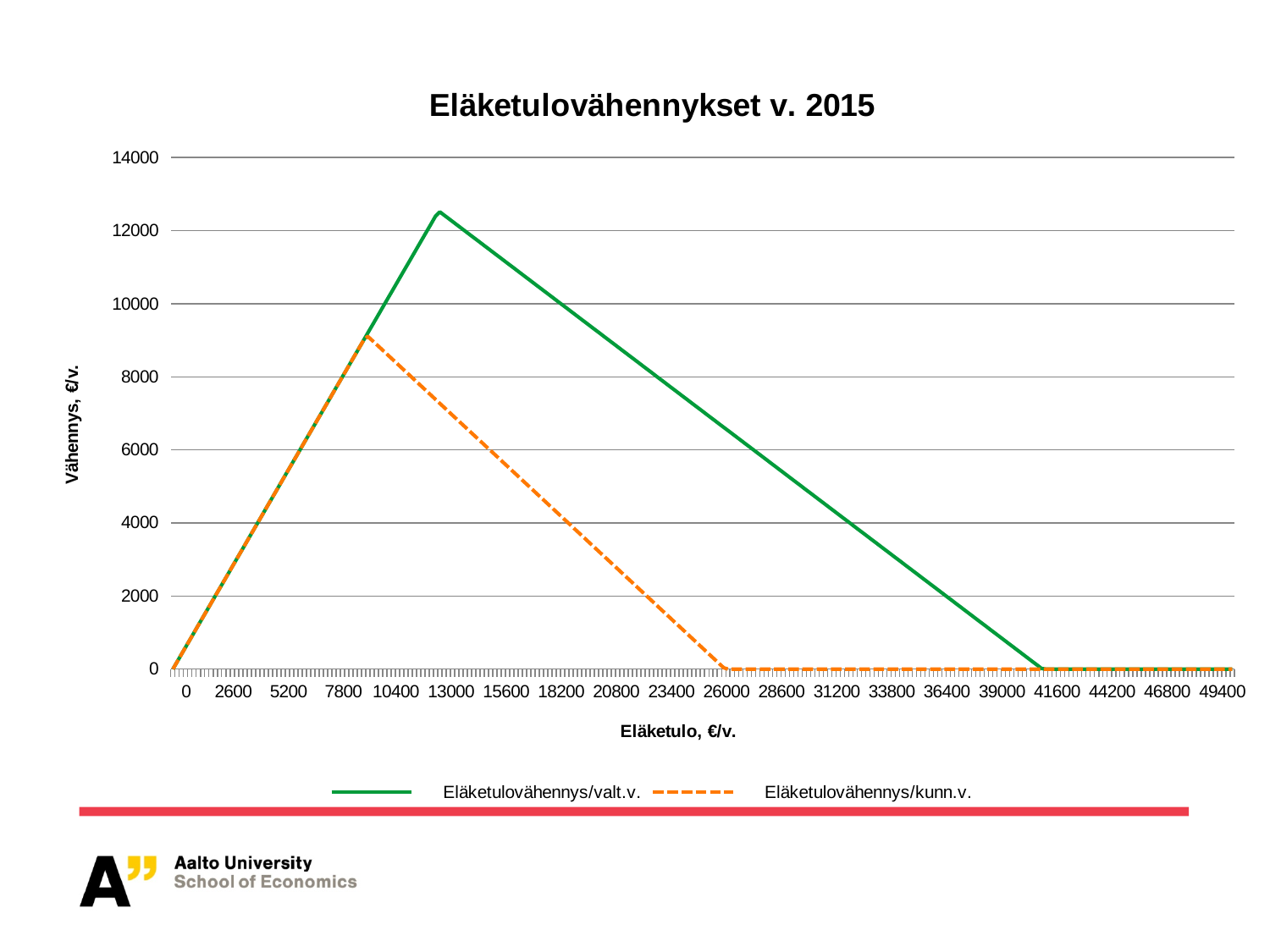
Is the value of Eläketulovähennys/valt.v. at Eläketulo 33800 greater or less than 4000? less Is the peak value of Eläketulovähennys/kunn.v. greater or less than 10000? less How many series does the legend list? 2 Is the value of Eläketulovähennys/kunn.v. at Eläketulo 13000 greater or less than 6000? greater What is the label of the y axis? Vähennys, €/v. At Eläketulo 20800, which series has the higher value, Eläketulovähennys/valt.v. or Eläketulovähennys/kunn.v.? Eläketulovähennys/valt.v. What kind of chart is shown on the slide? line chart What is the value of Eläketulovähennys/kunn.v. at Eläketulo 49400? 0 What is the title of the chart? Eläketulovähennykset v. 2015 What is the value of Eläketulovähennys/valt.v. at Eläketulo 0? 0 Which series reaches its peak at a higher Eläketulo value, Eläketulovähennys/valt.v. or Eläketulovähennys/kunn.v.? Eläketulovähennys/valt.v.